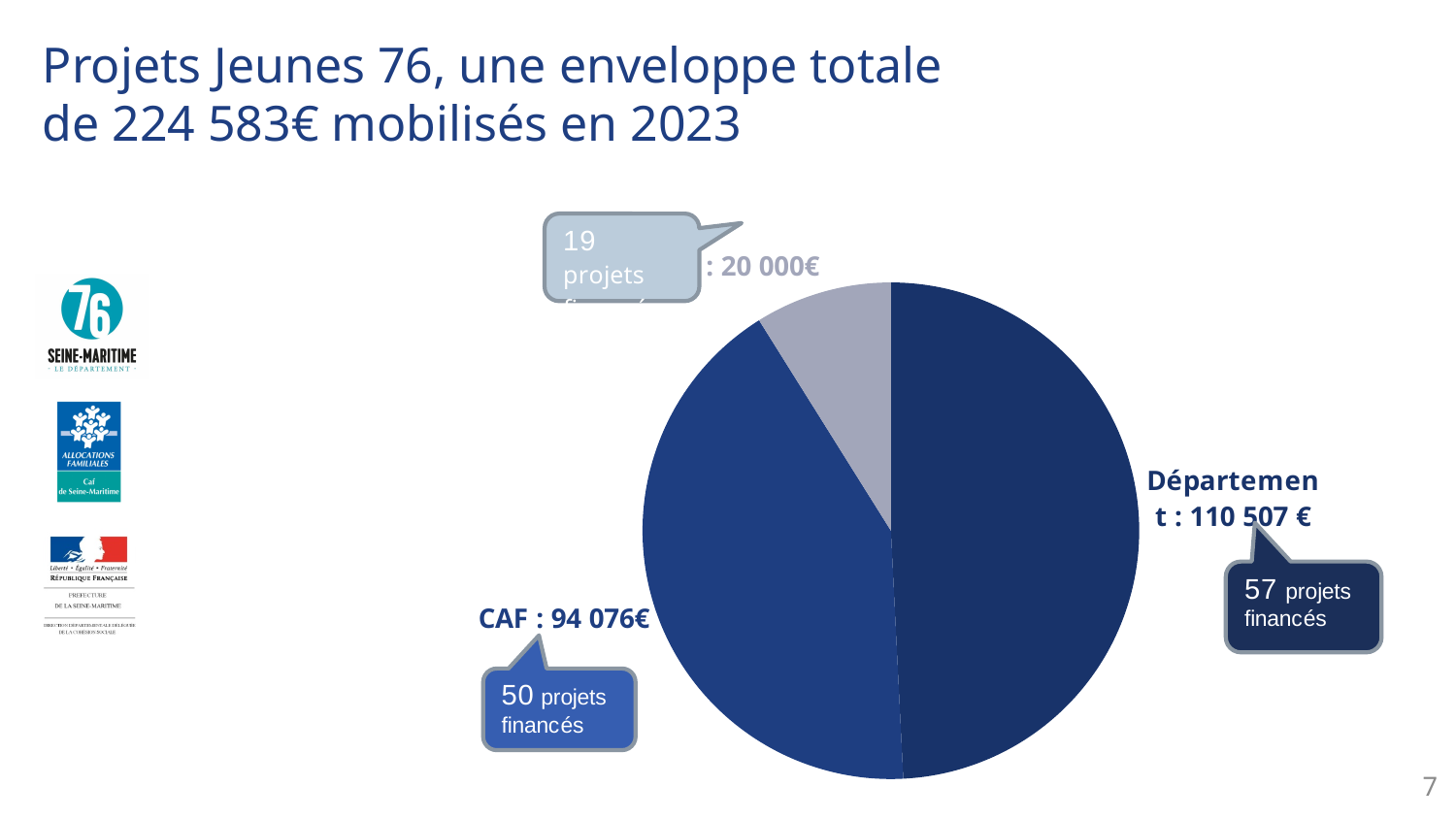
How many projects were financed with the 20 000€ slice according to its callout? 19 What amount is shown for CAF in the pie chart? 94 076€ Which slice of the pie chart is the largest? Département How many projects were financed by CAF according to the callout? 50 What is the difference between the Département amount and the CAF amount? 16 431 € What is the value of the smallest slice of the pie chart? 20 000€ What amount is shown for Département in the pie chart? 110 507 € What colour is the Département slice of the pie chart? dark blue How many slices does the pie chart have? 3 Which is larger, the Département amount or the CAF amount? Département How many projects were financed by the Département according to the callout? 57 What kind of chart is shown on the slide? pie chart